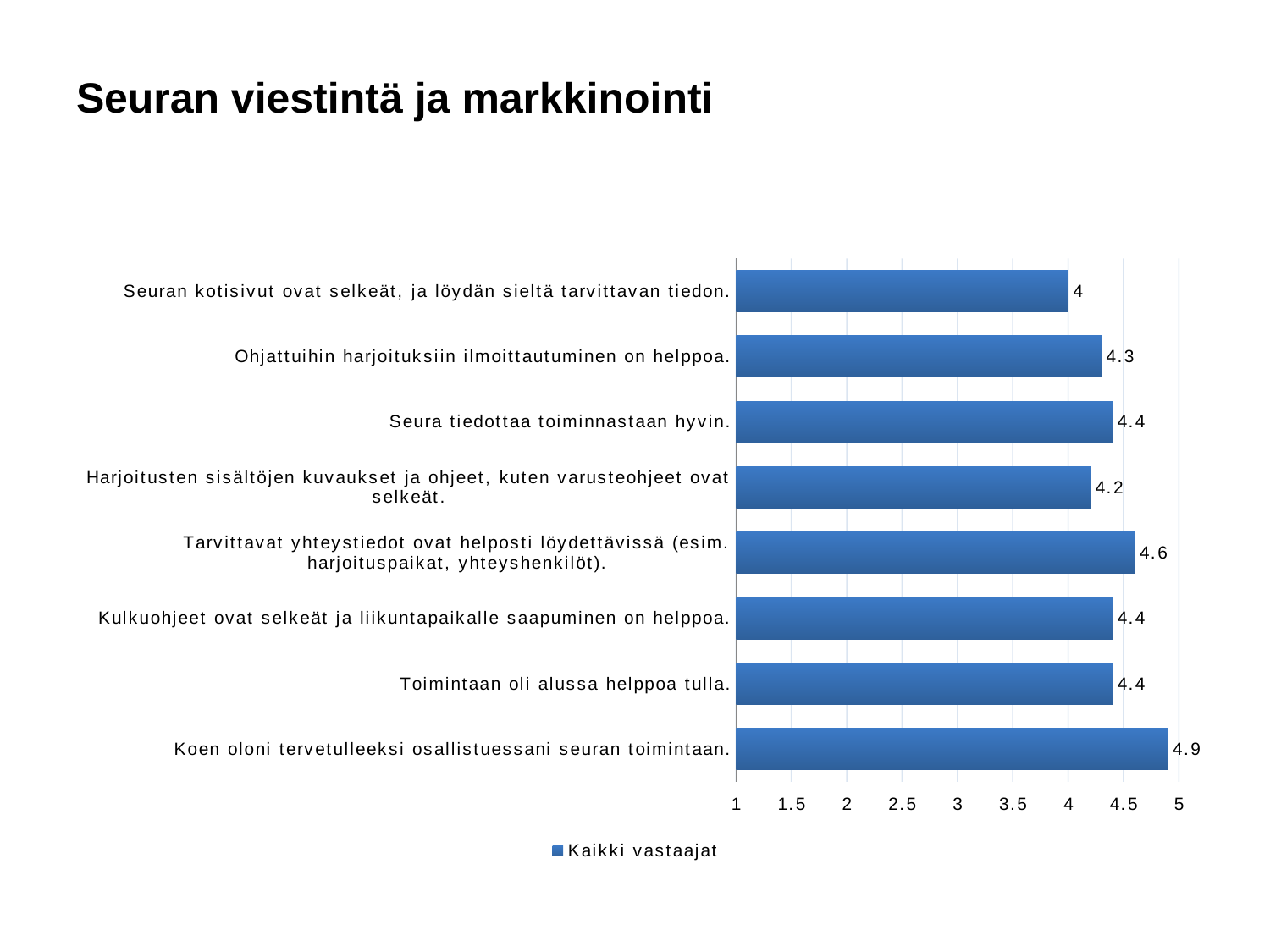
Which category has the lowest value? Seuran kotisivut ovat selkeät, ja löydän sieltä tarvittavan tiedon. What is the difference between the values for "Koen oloni tervetulleeksi osallistuessani seuran toimintaan." and "Seuran kotisivut ovat selkeät, ja löydän sieltä tarvittavan tiedon."? 0.9 What kind of chart is shown on the slide? bar chart How many series does the legend list? 1 What is the value for "Ohjattuihin harjoituksiin ilmoittautuminen on helppoa."? 4.3 What is the value for "Tarvittavat yhteystiedot ovat helposti löydettävissä (esim. harjoituspaikat, yhteyshenkilöt)."? 4.6 How many categories are shown in the chart? 8 Which category has the highest value? Koen oloni tervetulleeksi osallistuessani seuran toimintaan. Is the value for "Seura tiedottaa toiminnastaan hyvin." greater or less than 4? greater What is the value for "Seuran kotisivut ovat selkeät, ja löydän sieltä tarvittavan tiedon."? 4 What is the value for "Koen oloni tervetulleeksi osallistuessani seuran toimintaan."? 4.9 Which is larger: the value for "Tarvittavat yhteystiedot ovat helposti löydettävissä (esim. harjoituspaikat, yhteyshenkilöt)." or for "Harjoitusten sisältöjen kuvaukset ja ohjeet, kuten varusteohjeet ovat selkeät."? Tarvittavat yhteystiedot ovat helposti löydettävissä (esim. harjoituspaikat, yhteyshenkilöt).